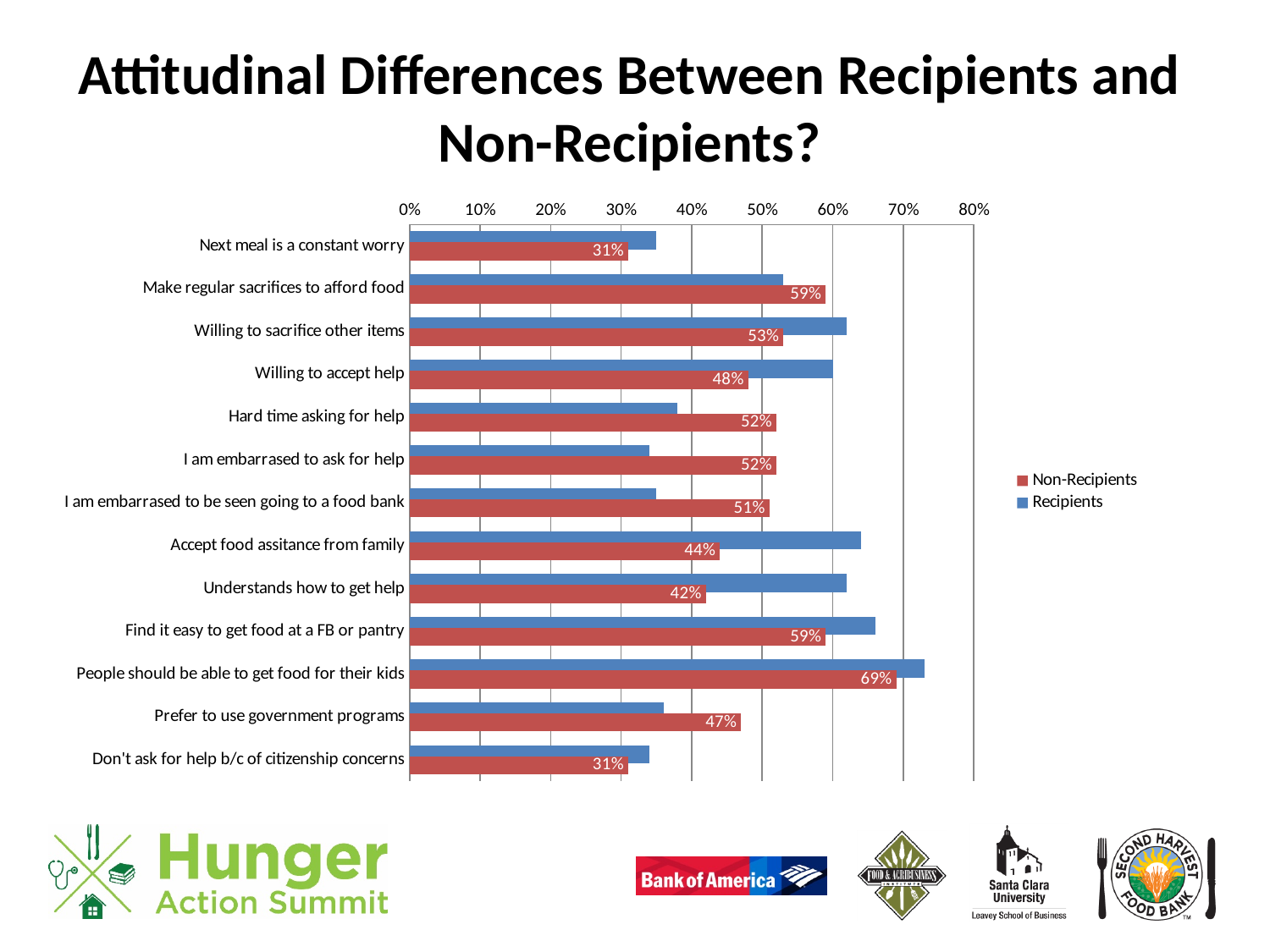
For "Willing to accept help", which series has the larger value, Recipients or Non-Recipients? Recipients What is the Non-Recipients value for "Understands how to get help"? 42% What kind of chart is shown on the slide? bar chart Which statement has the highest Non-Recipients value? People should be able to get food for their kids Is the Recipients value for "I am embarrased to ask for help" greater or less than 40%? less How many categories (statements) are plotted on the chart? 13 What is the Non-Recipients value for "Willing to accept help"? 48% How many series does the legend list? 2 For "Hard time asking for help", which series has the larger value, Recipients or Non-Recipients? Non-Recipients What is the difference between the Non-Recipients values for "People should be able to get food for their kids" and "Next meal is a constant worry"? 38% Is the Recipients value for "People should be able to get food for their kids" greater or less than 70%? greater What is the Non-Recipients value for "People should be able to get food for their kids"? 69%